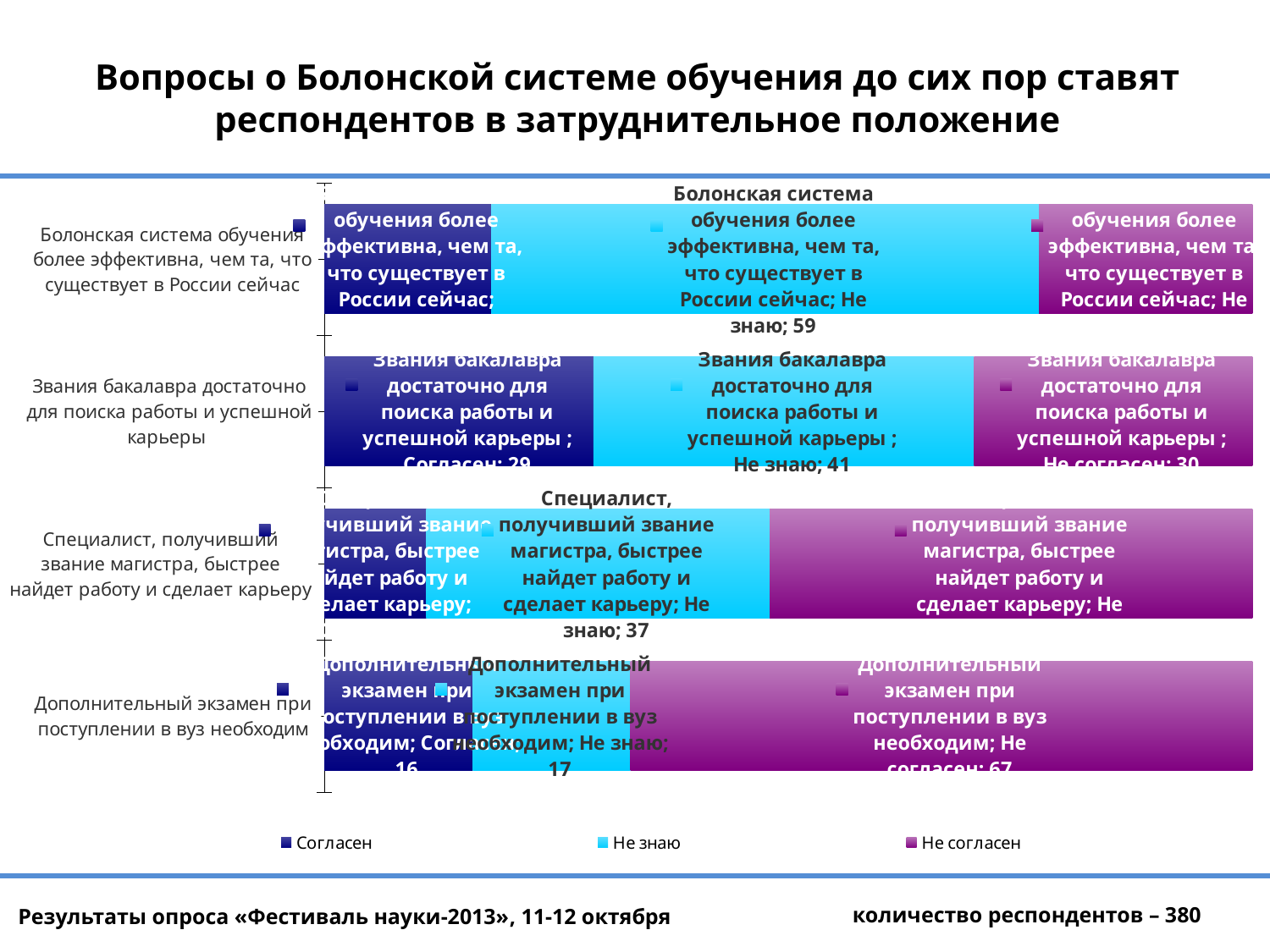
What is the difference between "Не согласен" and "Согласен" for "Дополнительный экзамен при поступлении в вуз необходим"? 51 What kind of chart is shown on the slide? Stacked bar chart Which category has the highest "Не знаю" value? Болонская система обучения более эффективна, чем та, что существует в России сейчас What is the value of "Не знаю" for the category "Болонская система обучения более эффективна, чем та, что существует в России сейчас"? 59 How many categories (statements) are shown in the chart? 4 What is the value of "Не согласен" for the category "Дополнительный экзамен при поступлении в вуз необходим"? 67 What is the total of the stacked bar for "Звания бакалавра достаточно для поиска работы и успешной карьеры"? 100 Which is larger: the "Не знаю" value for "Звания бакалавра достаточно для поиска работы и успешной карьеры" or for "Дополнительный экзамен при поступлении в вуз необходим"? Звания бакалавра достаточно для поиска работы и успешной карьеры How many series does the legend list? 3 What is the value of "Не знаю" for the category "Звания бакалавра достаточно для поиска работы и успешной карьеры"? 41 What is the value of "Не знаю" for the category "Специалист, получивший звание магистра, быстрее найдет работу и сделает карьеру"? 37 What is the value of "Согласен" for the category "Дополнительный экзамен при поступлении в вуз необходим"? 16